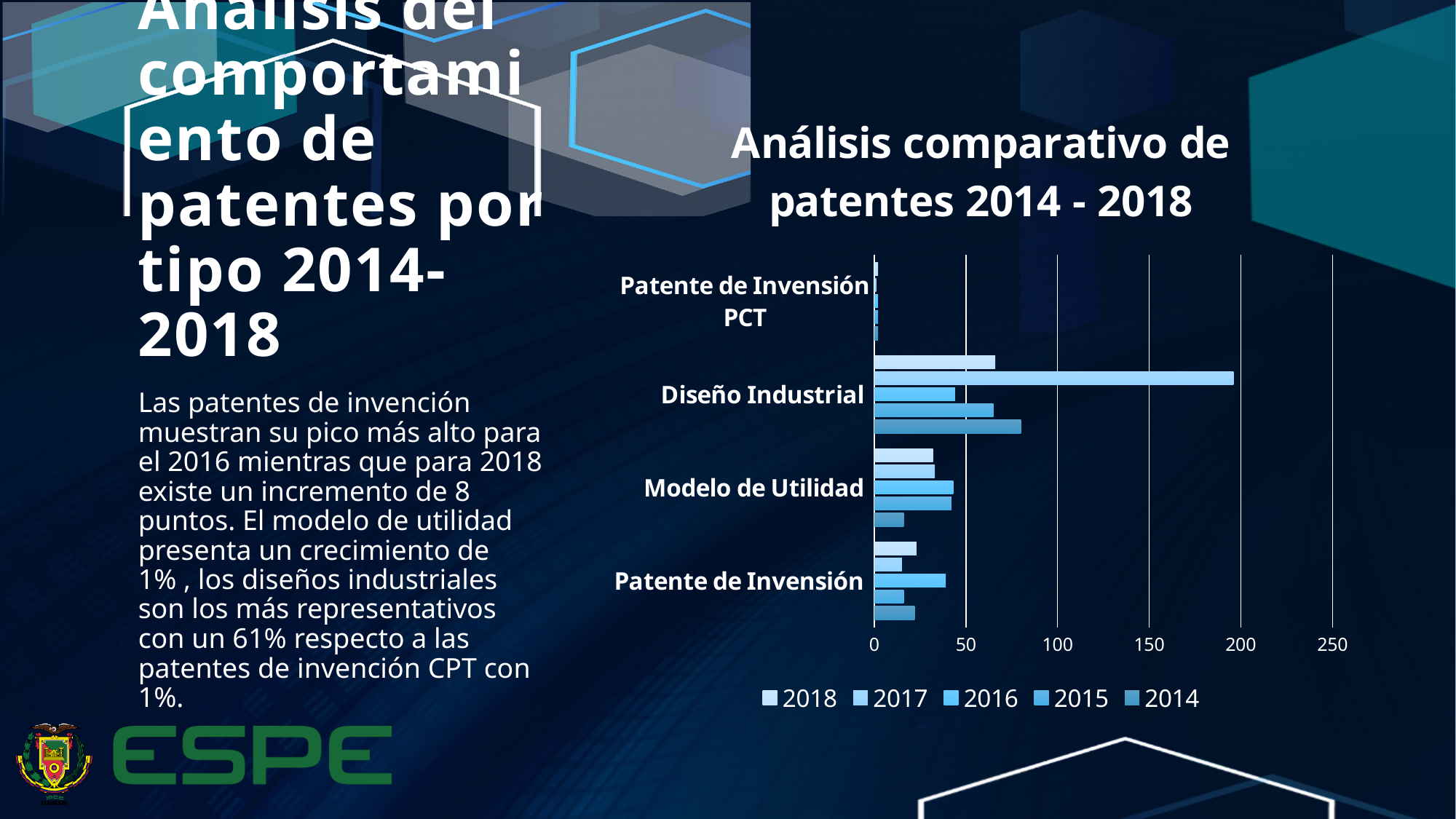
Which is larger for Patente de Invención, the 2016 value or the 2015 value? 2016 Is the 2014 value for Modelo de Utilidad greater or less than 50? less Is the 2017 value for Patente de Invensión PCT greater or less than 50? less How many series does the chart legend list? 5 Is the 2014 value for Diseño Industrial greater or less than 50? greater How many patent categories are shown on the chart? 4 Which category has the smallest bars overall on the chart? Patente de Invensión PCT Which category has the longest bar on the chart? Diseño Industrial Which is larger, the 2017 value for Diseño Industrial or the 2017 value for Modelo de Utilidad? Diseño Industrial What kind of chart is shown on the slide? bar chart What is the title of the chart? Análisis comparativo de patentes 2014 - 2018